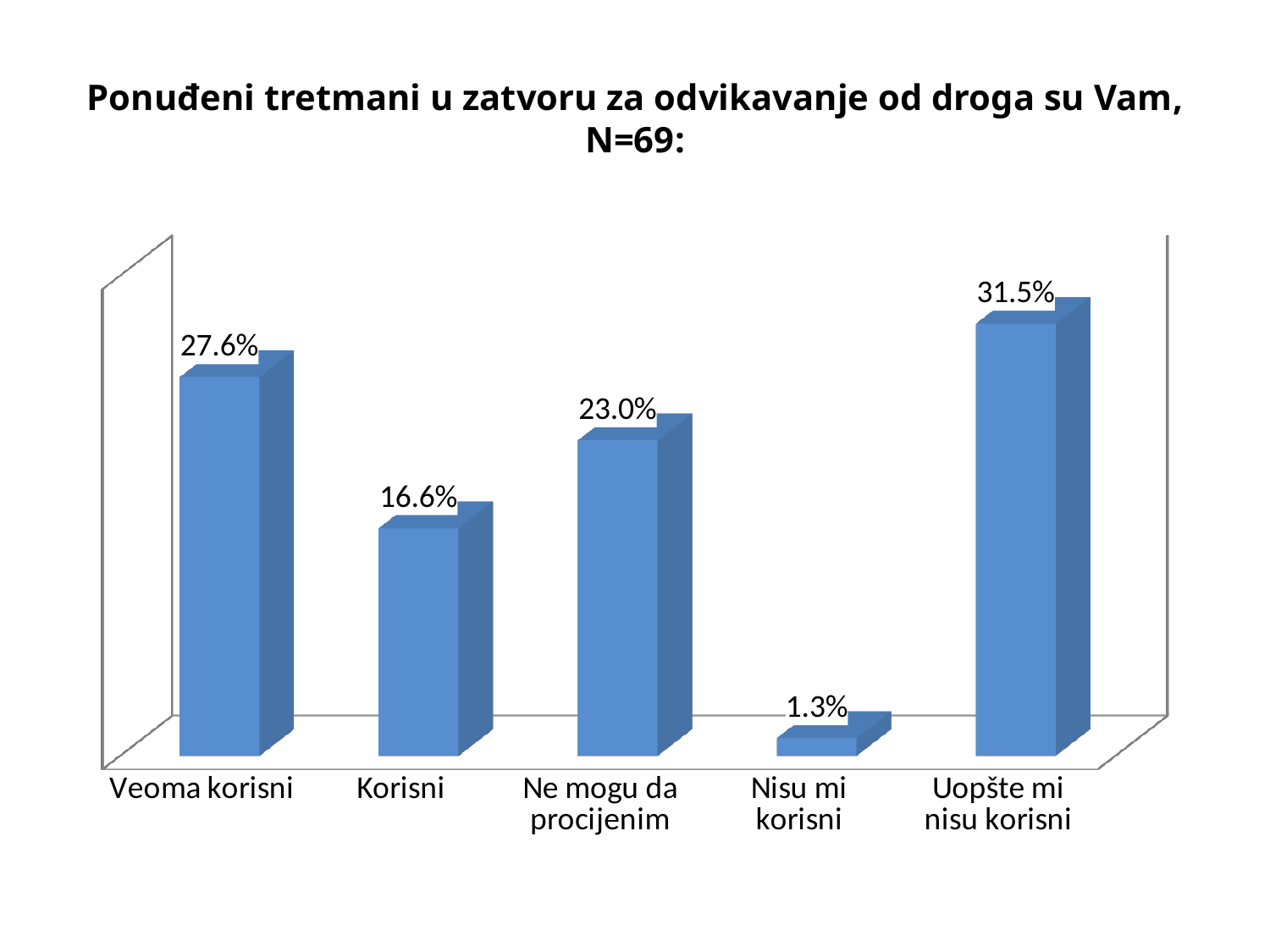
Which is larger, the value for "Ne mogu da procijenim" or the value for "Korisni"? Ne mogu da procijenim What is the difference between the values for "Uopšte mi nisu korisni" and "Veoma korisni"? 3.9% What is the value for "Veoma korisni"? 27.6% What is the value for "Korisni"? 16.6% Which category has the lowest value? Nisu mi korisni What is the value for "Ne mogu da procijenim"? 23.0% How many categories are shown on the chart? 5 What is the value for "Uopšte mi nisu korisni"? 31.5% What kind of chart is shown on the slide? Bar chart Which category has the highest value? Uopšte mi nisu korisni What is the value for "Nisu mi korisni"? 1.3% What is the N value stated in the chart title? N=69